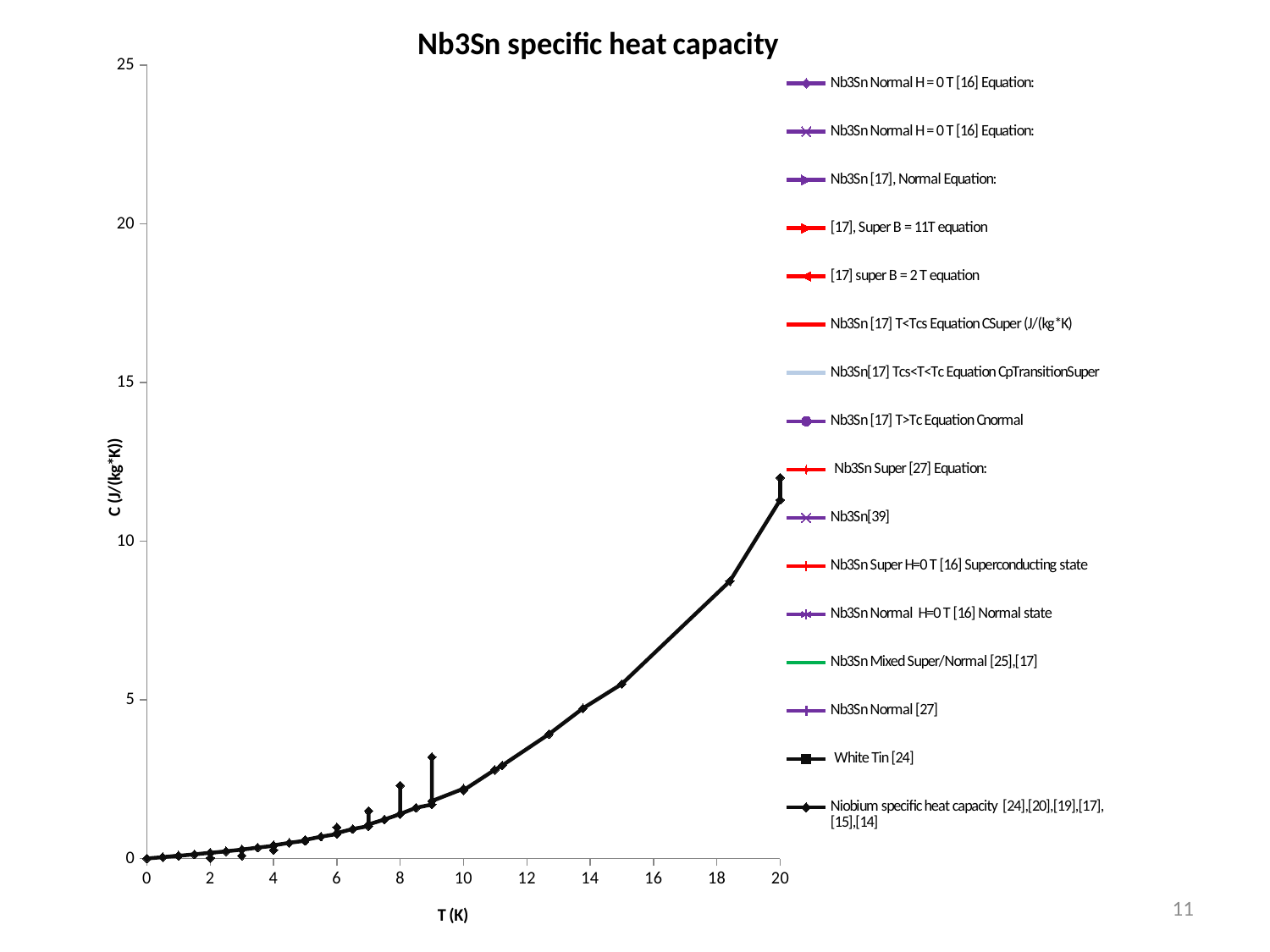
Which is larger, the plotted value at T = 20 K or at T = 10 K? T = 20 K What is the label of the x axis? T (K) Is the plotted value at T = 20 K greater or less than 15? less What is the highest value shown on the y axis? 25 Is the plotted value at T = 18 K greater or less than 5? greater What is the title of the chart? Nb3Sn specific heat capacity Is the plotted value at T = 10 K greater or less than 5? less Does the plotted specific heat capacity rise or fall as T increases from 0 to 20 K? rise How many series does the legend list? 16 What kind of chart is shown on the slide? line chart